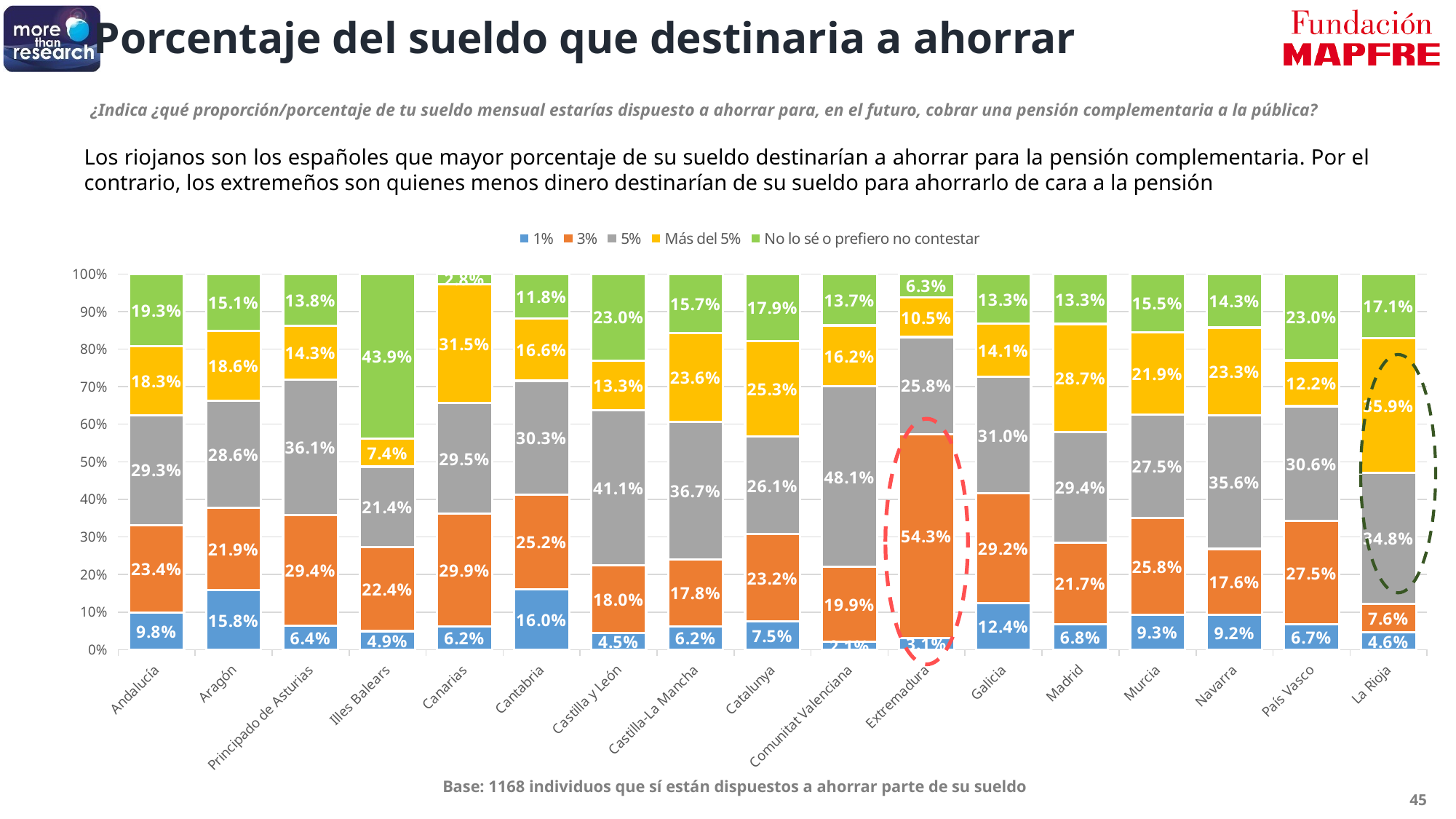
Which is larger: the 'Más del 5%' value for Madrid or for Murcia? Madrid What is the value of the '3%' series for Extremadura? 54.3% What is the base (number of individuals) stated below the chart? 1168 What is the value of the 'No lo sé o prefiero no contestar' series for Illes Balears? 43.9% Which region has the lowest value for the 'Más del 5%' series? Illes Balears What is the value of the '5%' series for Comunitat Valenciana? 48.1% What is the value of the '1%' series for Cantabria? 16.0% What type of chart is shown on the slide? Stacked bar chart How many series does the legend list? 5 How many regions (categories) are shown on the x axis? 17 What is the difference between the '5%' values for Castilla y León (41.1%) and Andalucía (29.3%)? 11.8 percentage points Which region has the highest value for the '3%' series? Extremadura